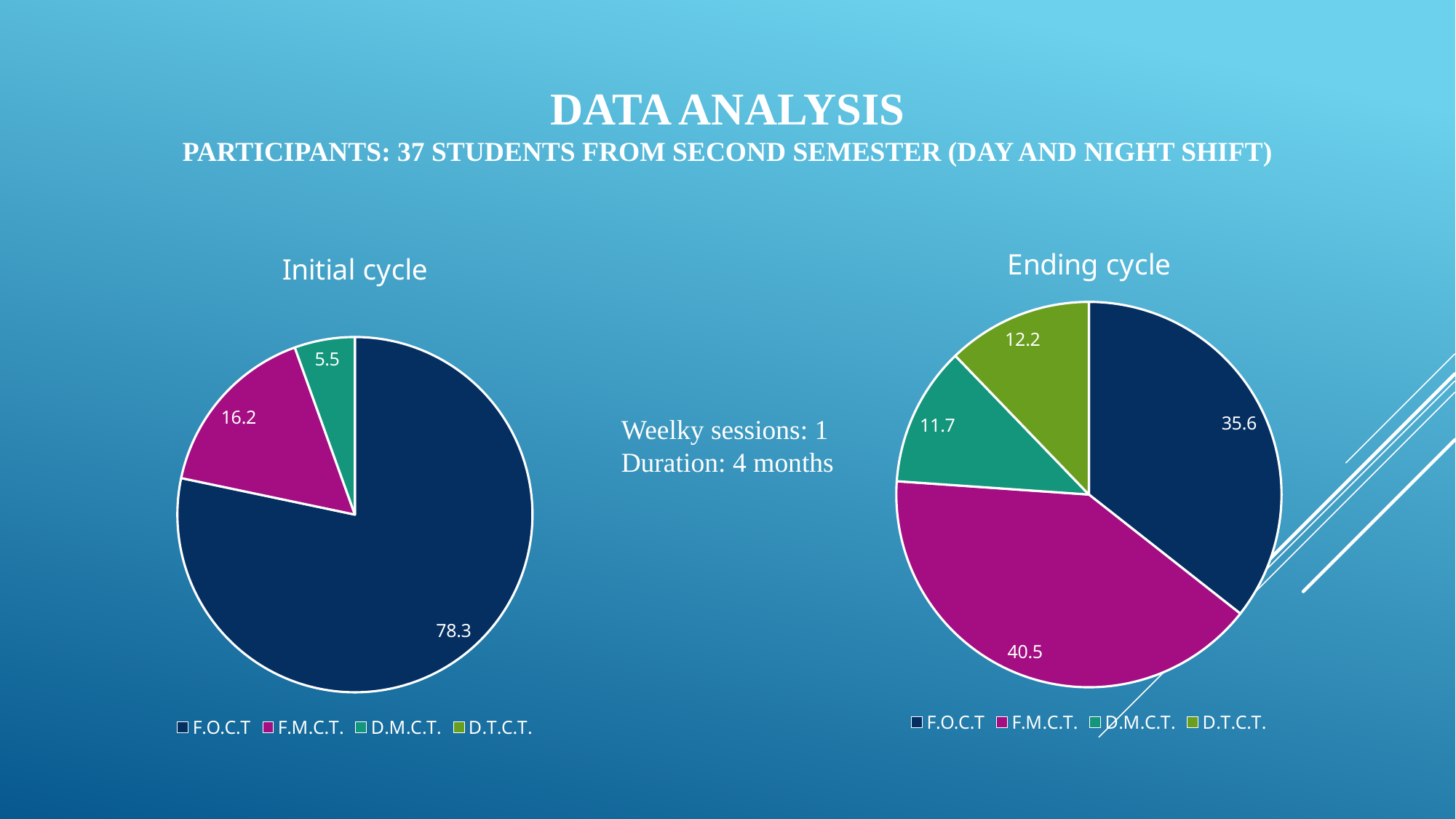
In the Initial cycle chart, what is the value for F.M.C.T.? 16.2 How many entries does the legend of the Ending cycle chart list? 4 In the Ending cycle chart, which category has the largest slice? F.M.C.T. In the Ending cycle chart, what is the difference between the F.M.C.T. and F.O.C.T values? 4.9 In the Ending cycle chart, what is the value for D.T.C.T.? 12.2 What colour is the F.M.C.T. slice in the Ending cycle chart? Magenta What kind of chart is the Initial cycle chart? Pie chart In the Ending cycle chart, what is the value for F.M.C.T.? 40.5 How many slices are visible in the Initial cycle pie chart? 3 In the Ending cycle chart, which is larger: D.M.C.T. or D.T.C.T.? D.T.C.T. In the Initial cycle chart, which labelled category has the smallest slice? D.M.C.T. In the Initial cycle chart, what is the value for F.O.C.T? 78.3